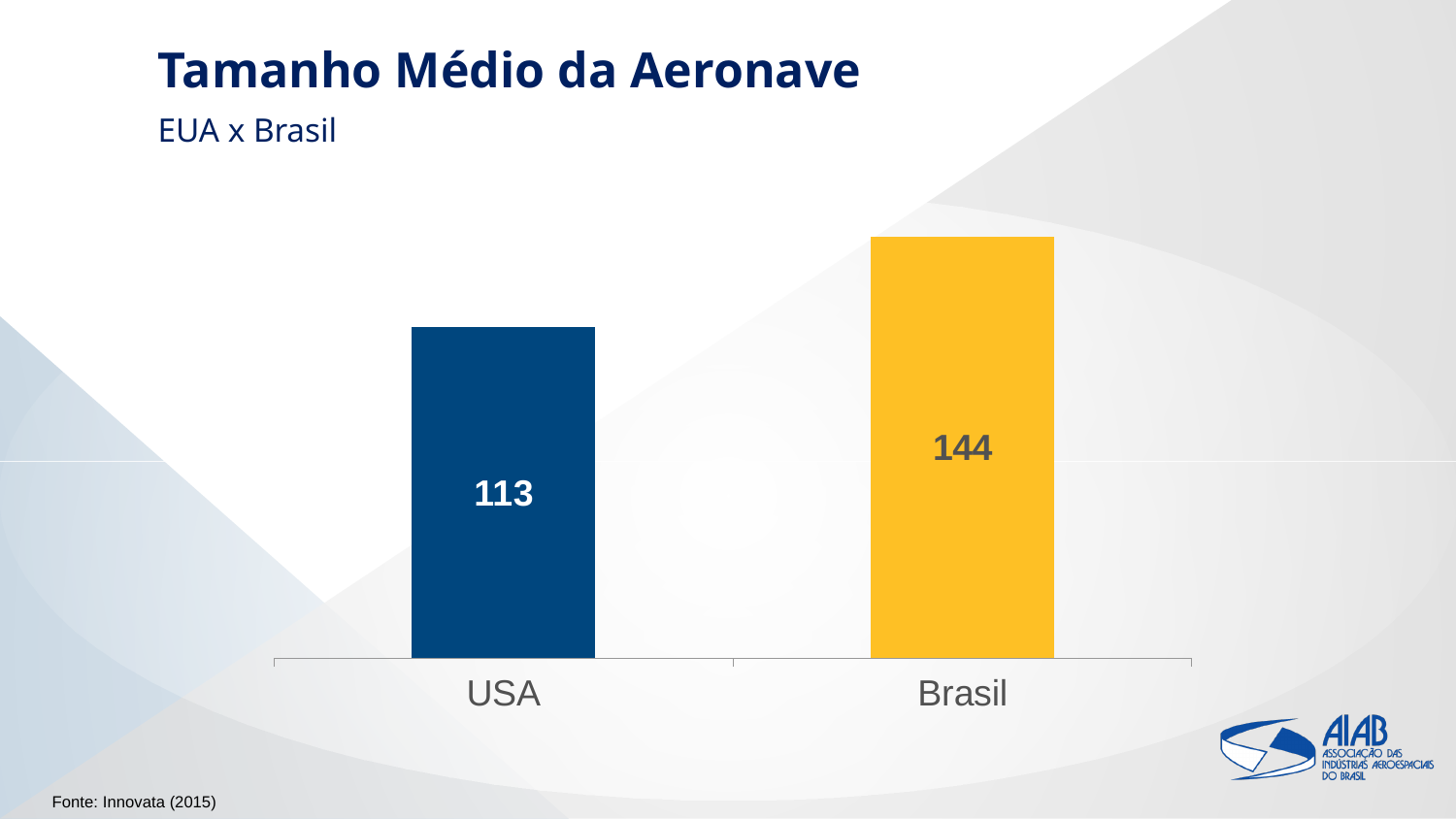
Which category has the lowest value? USA What colour is the bar for Brasil? Yellow Which is larger, the value for USA or the value for Brasil? Brasil What is the value for Brasil? 144 What is the value for USA? 113 What is the title of the slide? Tamanho Médio da Aeronave Which category has the highest value? Brasil What kind of chart is shown on the slide? Bar chart What is the difference between the values for Brasil and USA? 31 How many categories are shown in the chart? 2